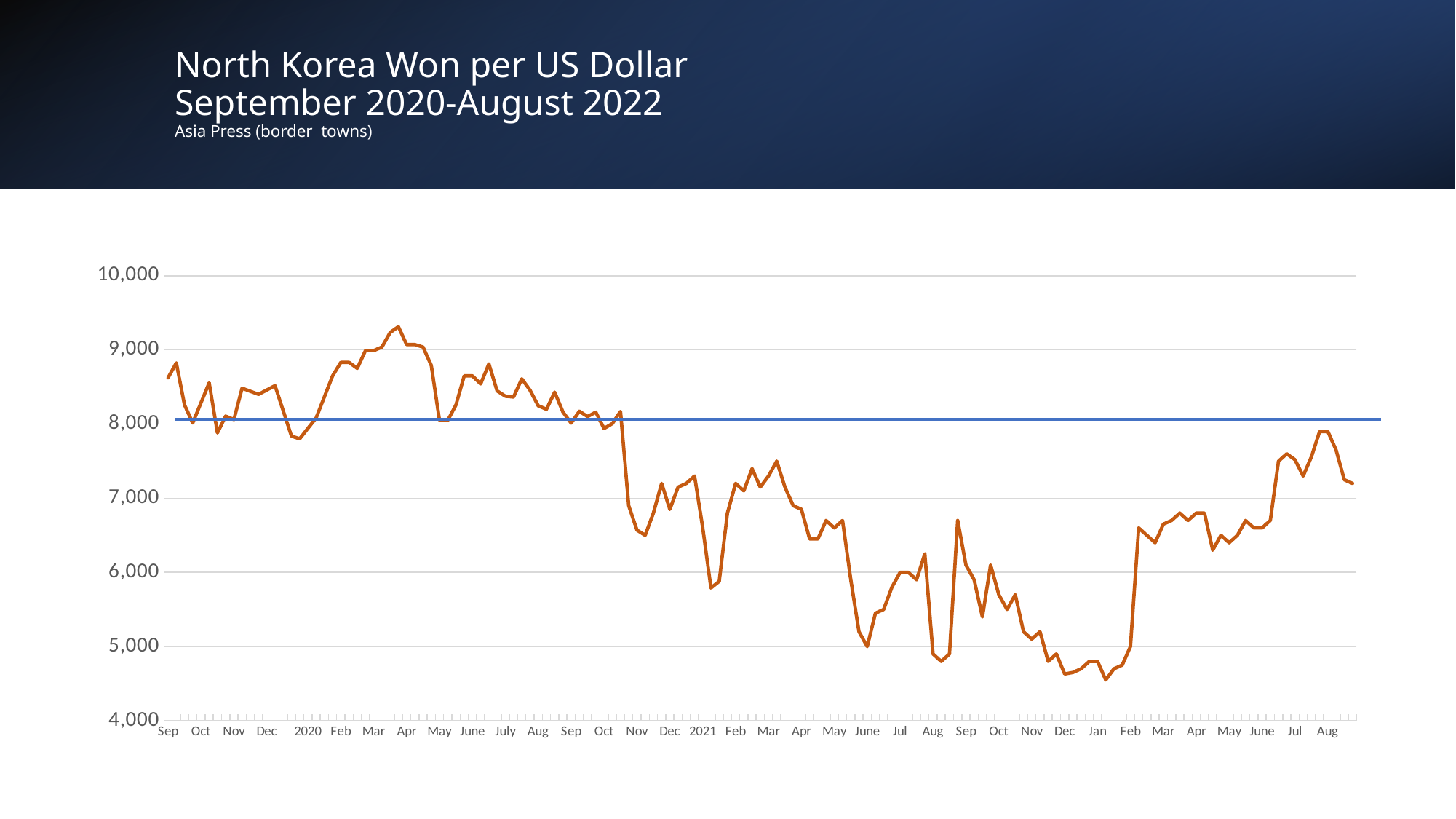
What is the title of the chart? North Korea Won per US Dollar September 2020-August 2022 Does the orange line generally rise or fall between the Apr tick on the left and the Jan tick on the right? fall Is the peak of the orange line near the Apr tick (left part of the chart) greater or less than 9,000? greater What source is given beneath the chart title? Asia Press (border towns) Around which month label does the orange line reach its lowest point? Jan Is the value of the orange line at the final Aug tick greater or less than 7,000? greater Around which month label does the orange line reach its highest point? Apr What kind of chart is shown on the slide? line chart Is the value of the orange line at the Nov tick following the Oct tick in the middle of the chart greater or less than 8,000? less Does the orange line rise or fall between the Feb tick on the right and the Jul tick on the right? rise